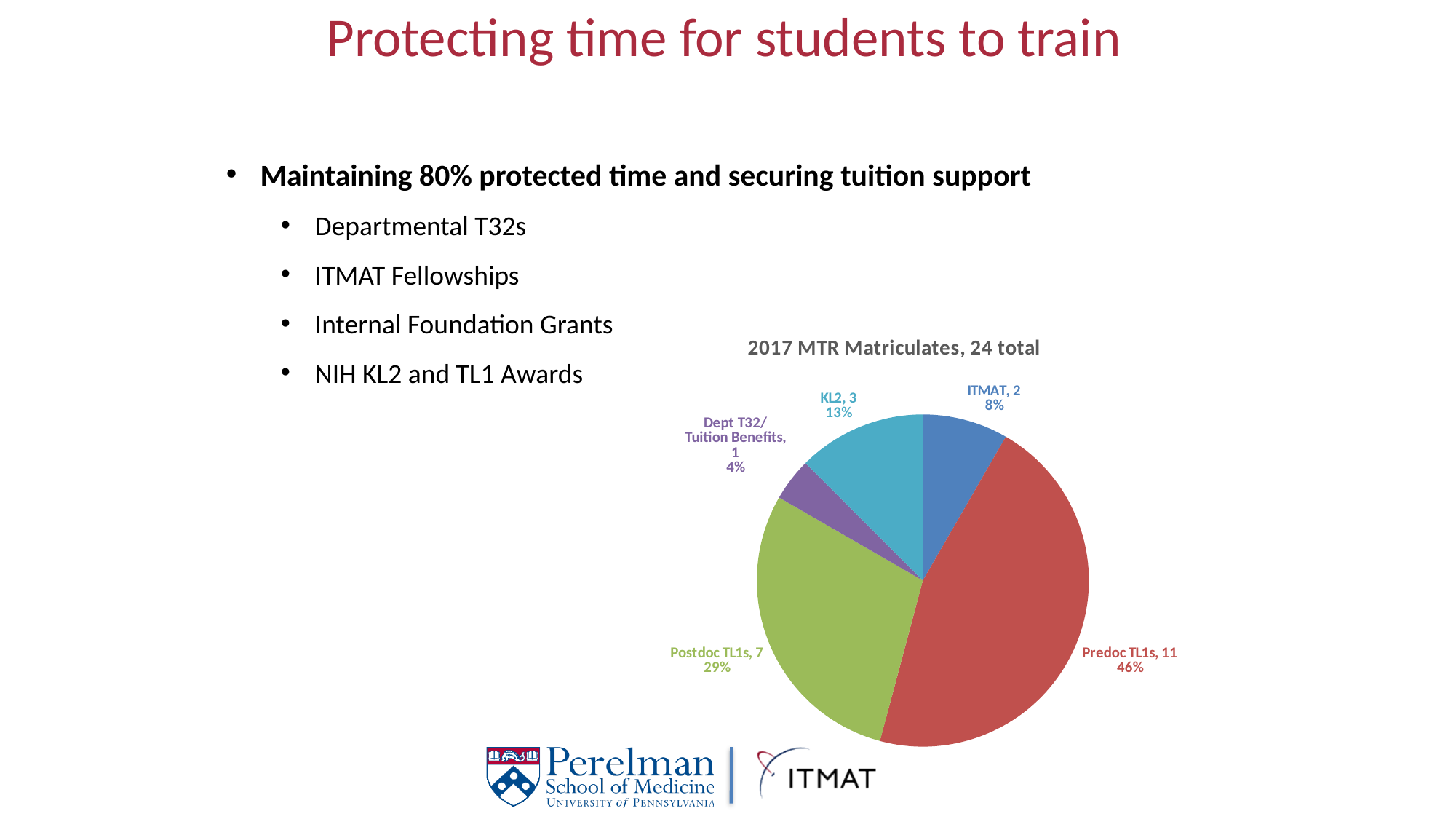
How many slices does the pie chart have? 5 What type of chart is shown on the slide? pie chart What is the difference between the Predoc TL1s and Postdoc TL1s counts? 4 Which is larger, KL2 or ITMAT? KL2 Which category has the smallest slice? Dept T32/Tuition Benefits What percentage share does ITMAT have? 8% Which category has the largest slice? Predoc TL1s How many matriculates are Predoc TL1s? 11 What is the title of the chart? 2017 MTR Matriculates, 24 total How many matriculates are Postdoc TL1s? 7 What is the value for KL2? 3 What percentage share does Postdoc TL1s have? 29%